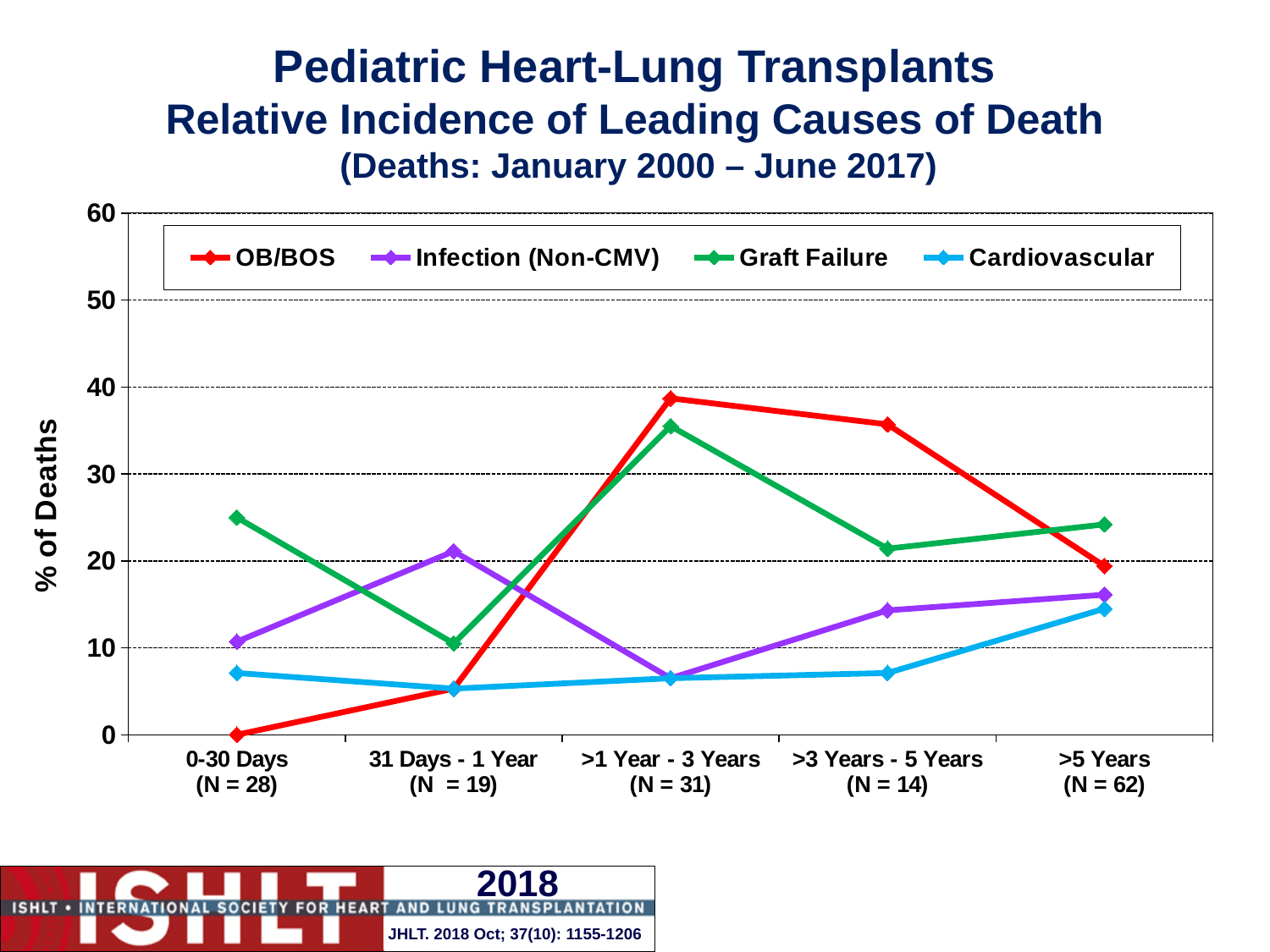
In which time period is the Graft Failure value highest? >1 Year - 3 Years Which series has the highest value at >1 Year - 3 Years? OB/BOS What kind of chart is shown on the slide? line chart How many time-period categories are shown on the x axis? 5 At >5 Years, which is larger: Graft Failure or OB/BOS? Graft Failure What is the label of the y axis? % of Deaths Does the OB/BOS line rise or fall from >1 Year - 3 Years to >5 Years? fall Is the value for OB/BOS at >1 Year - 3 Years greater or less than 30? greater In which time period is the Infection (Non-CMV) value lowest? >1 Year - 3 Years What is the value for OB/BOS at 0-30 Days? 0 How many series does the legend list? 4 Is the value for Cardiovascular at 0-30 Days greater or less than 10? less